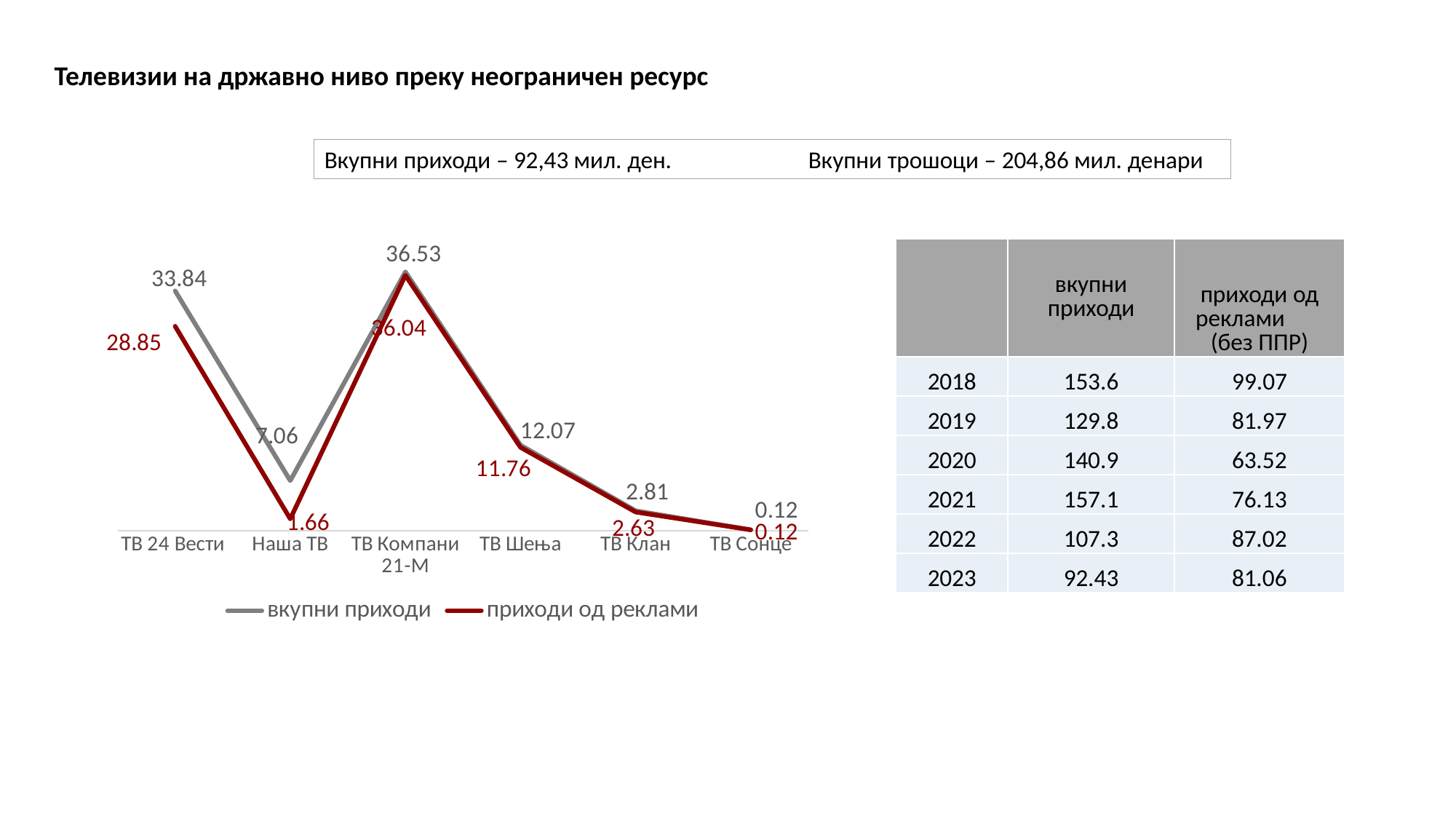
What colour is the line for приходи од реклами in the chart? red What type of chart is shown on the slide? line chart How many TV stations are plotted on the x axis of the chart? 6 How many series does the chart legend list? 2 Do the вкупни приходи values rise or fall from ТВ Компани 21-М to ТВ Сонце? fall What is the difference between вкупни приходи and приходи од реклами for ТВ 24 Вести? 4.99 Which TV station has the highest вкупни приходи? ТВ Компани 21-М Which is larger for ТВ Шења: вкупни приходи or приходи од реклами? вкупни приходи Which TV station has the lowest приходи од реклами? ТВ Сонце What is the value of вкупни приходи for ТВ 24 Вести? 33.84 What is the value of приходи од реклами for Наша ТВ? 1.66 What is the value of приходи од реклами for ТВ Компани 21-М? 36.04